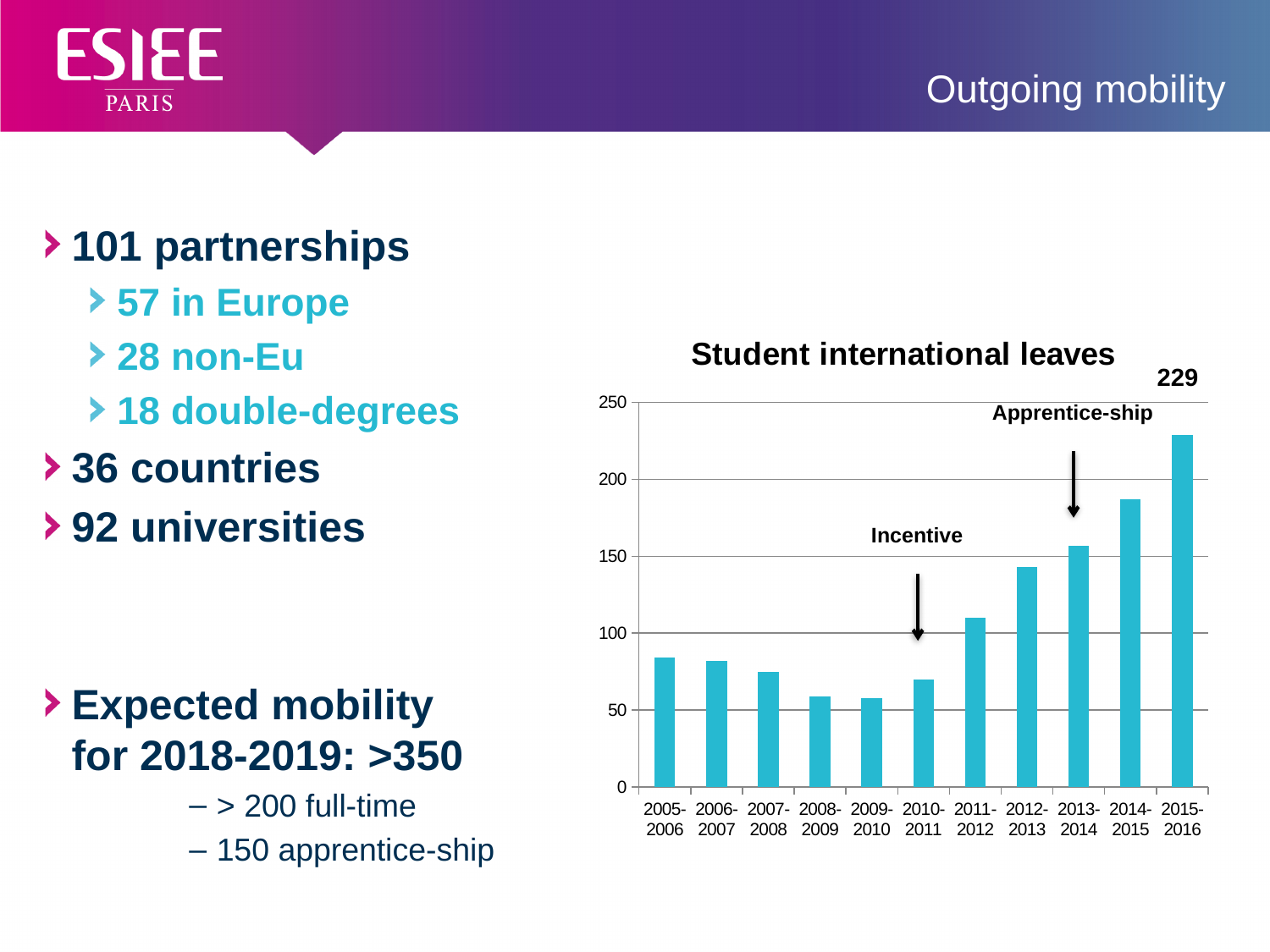
What is the value for 2015-2016 in the Student international leaves chart? 229 What kind of chart is used to show student international leaves? Bar chart What is the title of the chart on the slide? Student international leaves Is the value for 2008-2009 greater or less than 50? greater Which academic year has the highest number of student international leaves? 2015-2016 Is the value for 2005-2006 greater or less than 100? less Which has more student international leaves, 2010-2011 or 2013-2014? 2013-2014 Is the value for 2011-2012 greater or less than 100? greater How many academic years are shown on the x axis of the chart? 11 Do the values rise or fall from 2009-2010 to 2015-2016? Rise